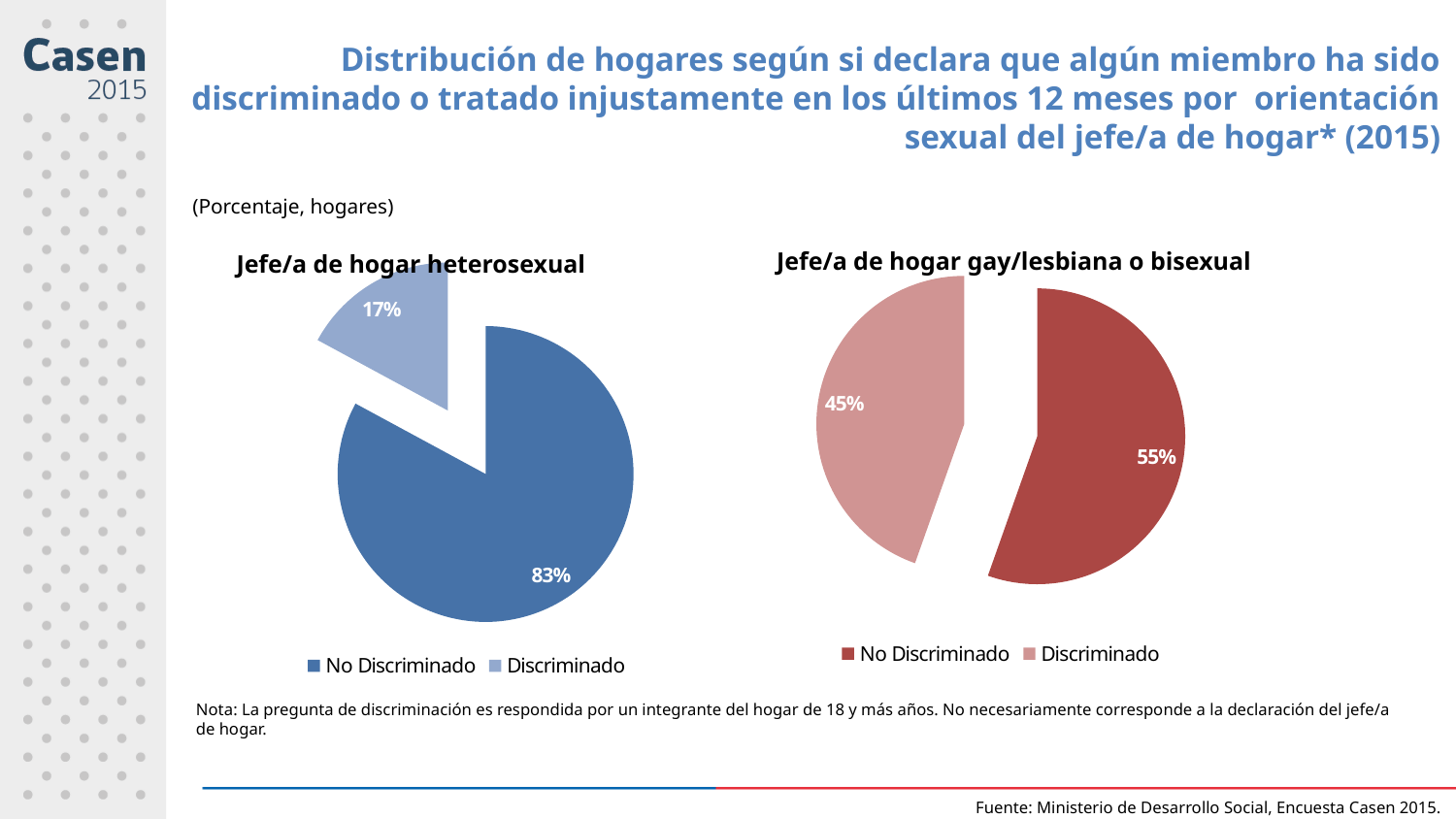
In the 'Jefe/a de hogar heterosexual' chart, which slice is the largest? No Discriminado In the 'Jefe/a de hogar gay/lesbiana o bisexual' chart, what is the value for No Discriminado? 55% In the 'Jefe/a de hogar gay/lesbiana o bisexual' chart, which slice is the smallest? Discriminado What type of chart is the 'Jefe/a de hogar heterosexual' chart? Pie chart How many entries does the legend of the 'Jefe/a de hogar heterosexual' chart list? 2 How many slices does the 'Jefe/a de hogar gay/lesbiana o bisexual' chart have? 2 In the 'Jefe/a de hogar gay/lesbiana o bisexual' chart, what is the value for Discriminado? 45% In the 'Jefe/a de hogar heterosexual' chart, what is the value for Discriminado? 17% Which is larger: Discriminado in the 'Jefe/a de hogar heterosexual' chart or Discriminado in the 'Jefe/a de hogar gay/lesbiana o bisexual' chart? Jefe/a de hogar gay/lesbiana o bisexual In the 'Jefe/a de hogar heterosexual' chart, what is the value for No Discriminado? 83% In the 'Jefe/a de hogar heterosexual' chart, what is the difference between No Discriminado and Discriminado? 66% In the 'Jefe/a de hogar gay/lesbiana o bisexual' chart, what is the difference between No Discriminado and Discriminado? 10%